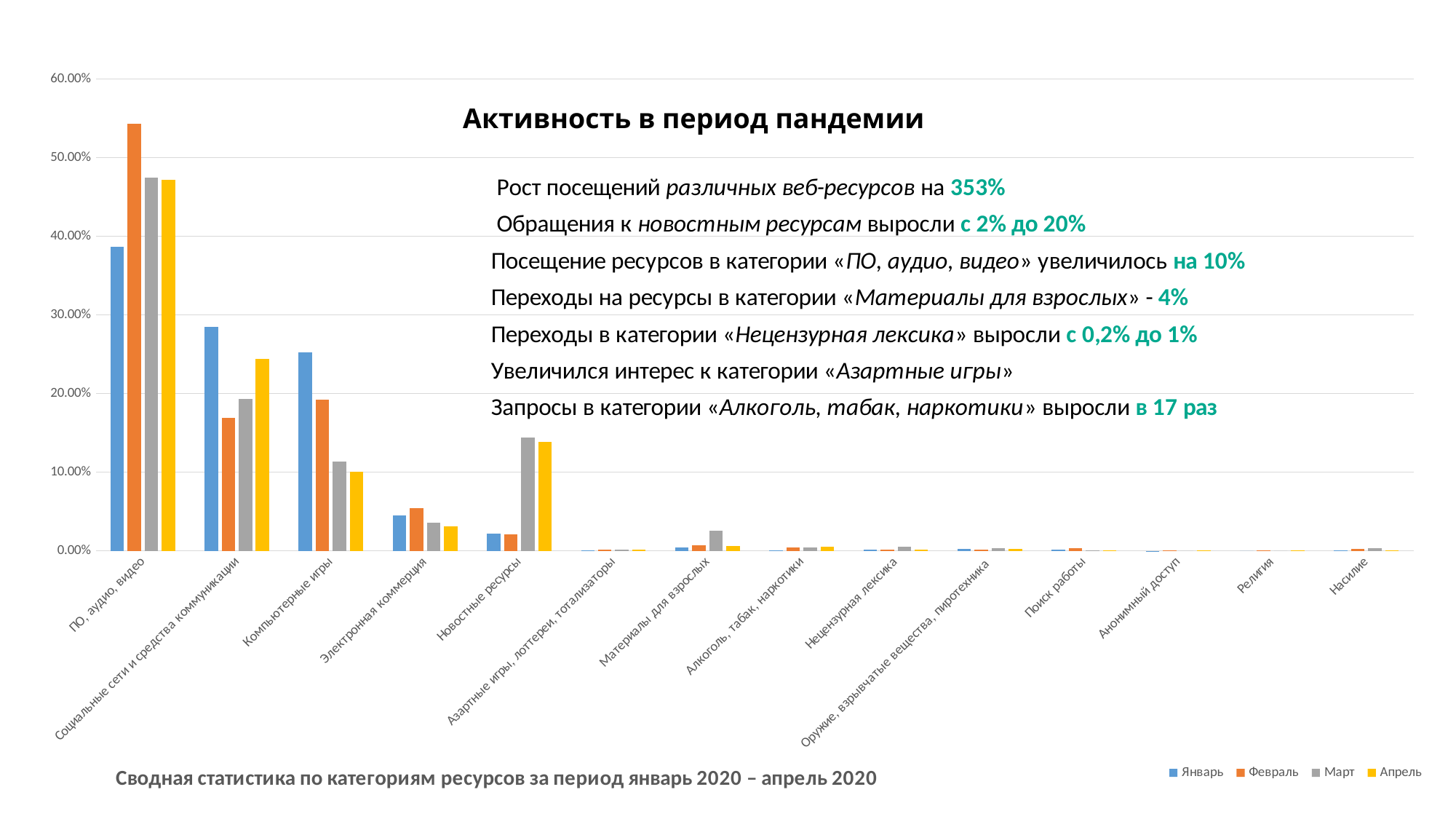
For Новостные ресурсы, which is larger: the Январь value or the Март value? Март How many categories are shown along the x axis of the chart? 14 Which category has the highest bar in the chart? ПО, аудио, видео For Компьютерные игры, do the values rise or fall from Январь to Апрель? fall For Социальные сети и средства коммуникации, which is larger: the Январь value or the Февраль value? Январь Is the Январь value for ПО, аудио, видео greater or less than 40%? less What kind of chart is shown on the slide? Bar chart How many series does the chart legend list? 4 Is the Март value for Новостные ресурсы greater or less than 10%? greater Is the Февраль value for Электронная коммерция greater or less than 10%? less Which colour represents the Апрель series in the legend? Yellow